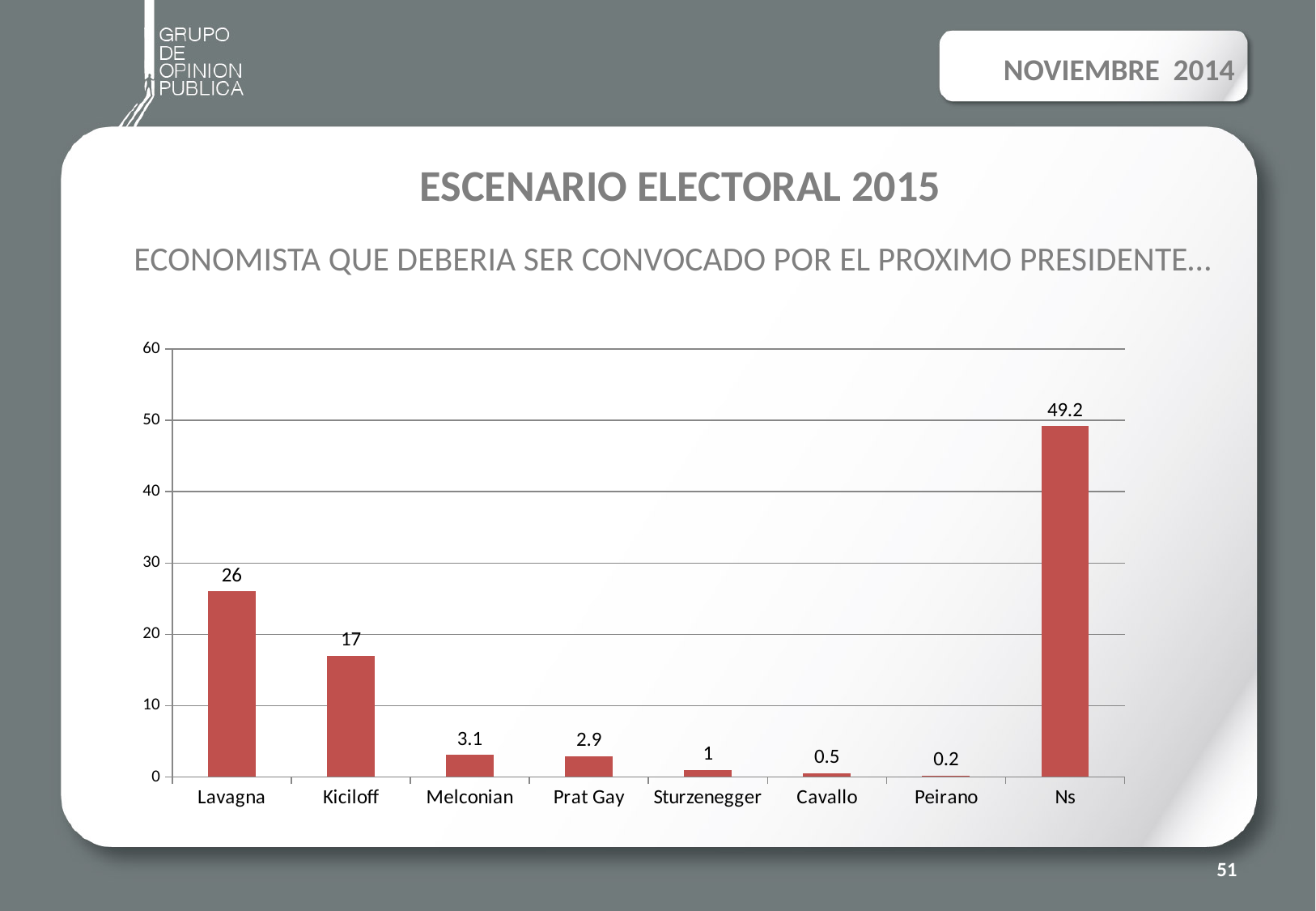
What is the difference between the values for Lavagna and Kiciloff? 9 What is the value for Peirano? 0.2 What is the value for Ns? 49.2 Which category has the lowest value? Peirano What kind of chart is shown on the slide? bar chart How many categories are shown on the x axis? 8 Which category has the highest value? Ns Is the value for Ns greater or less than 40? greater What is the title of the slide? ESCENARIO ELECTORAL 2015 What is the value for Kiciloff? 17 Which is larger, the value for Melconian or the value for Prat Gay? Melconian What is the value for Lavagna? 26